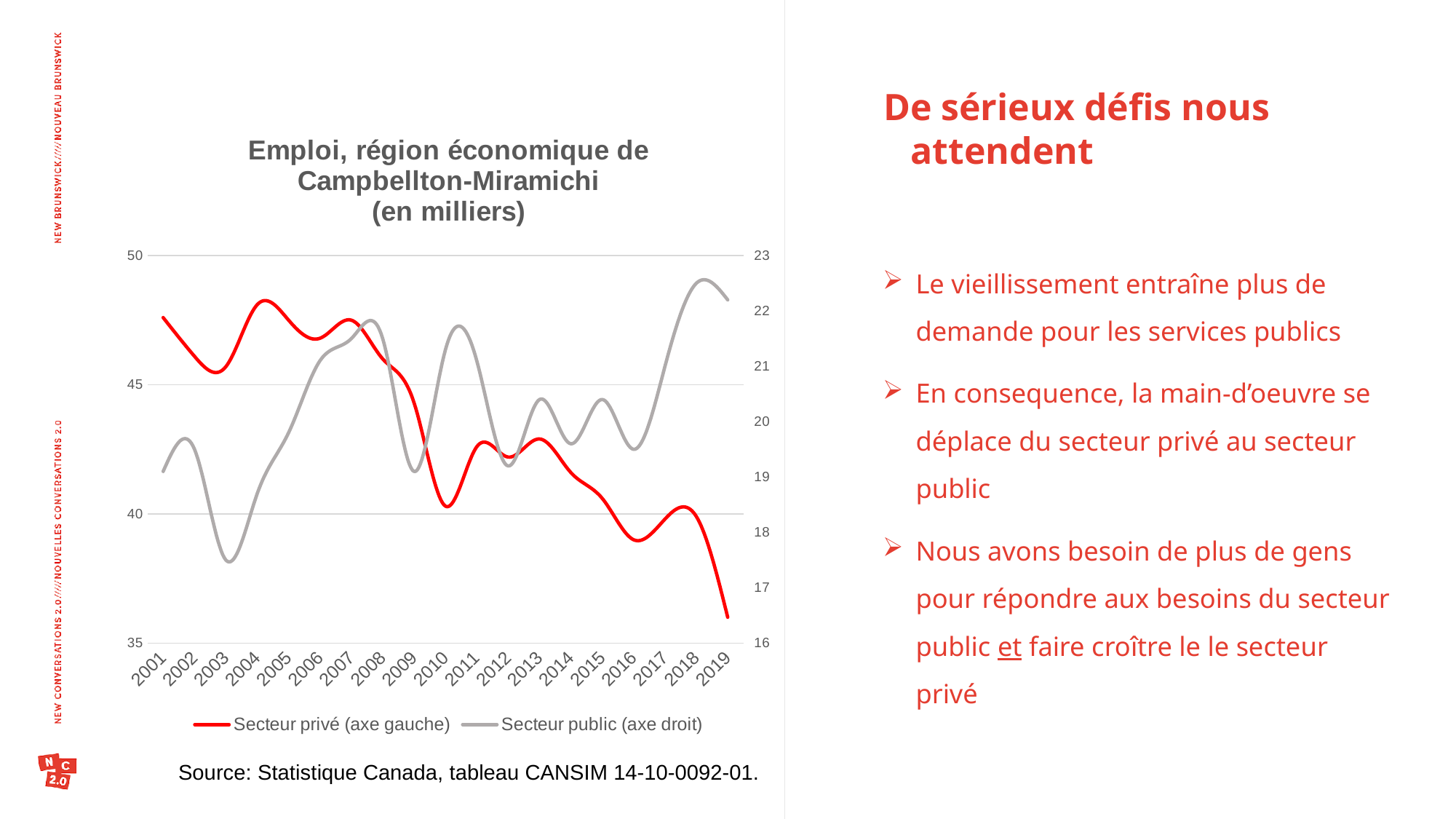
What kind of chart is shown on the slide? line chart In which year is the Secteur public value lowest? 2003 Is the Secteur privé value for 2001 greater or less than 45? greater What is the title of the chart? Emploi, région économique de Campbellton-Miramichi (en milliers) How many series does the legend list? 2 Does the Secteur privé series rise or fall overall from 2001 to 2019? fall In which year is the Secteur privé value lowest? 2019 Is the Secteur privé value for 2019 greater or less than 40? less Is the Secteur public value for 2018 greater or less than 22? greater In which year is the Secteur public value highest? 2018 Which series is drawn in red? Secteur privé (axe gauche) How many years are plotted along the x axis? 19